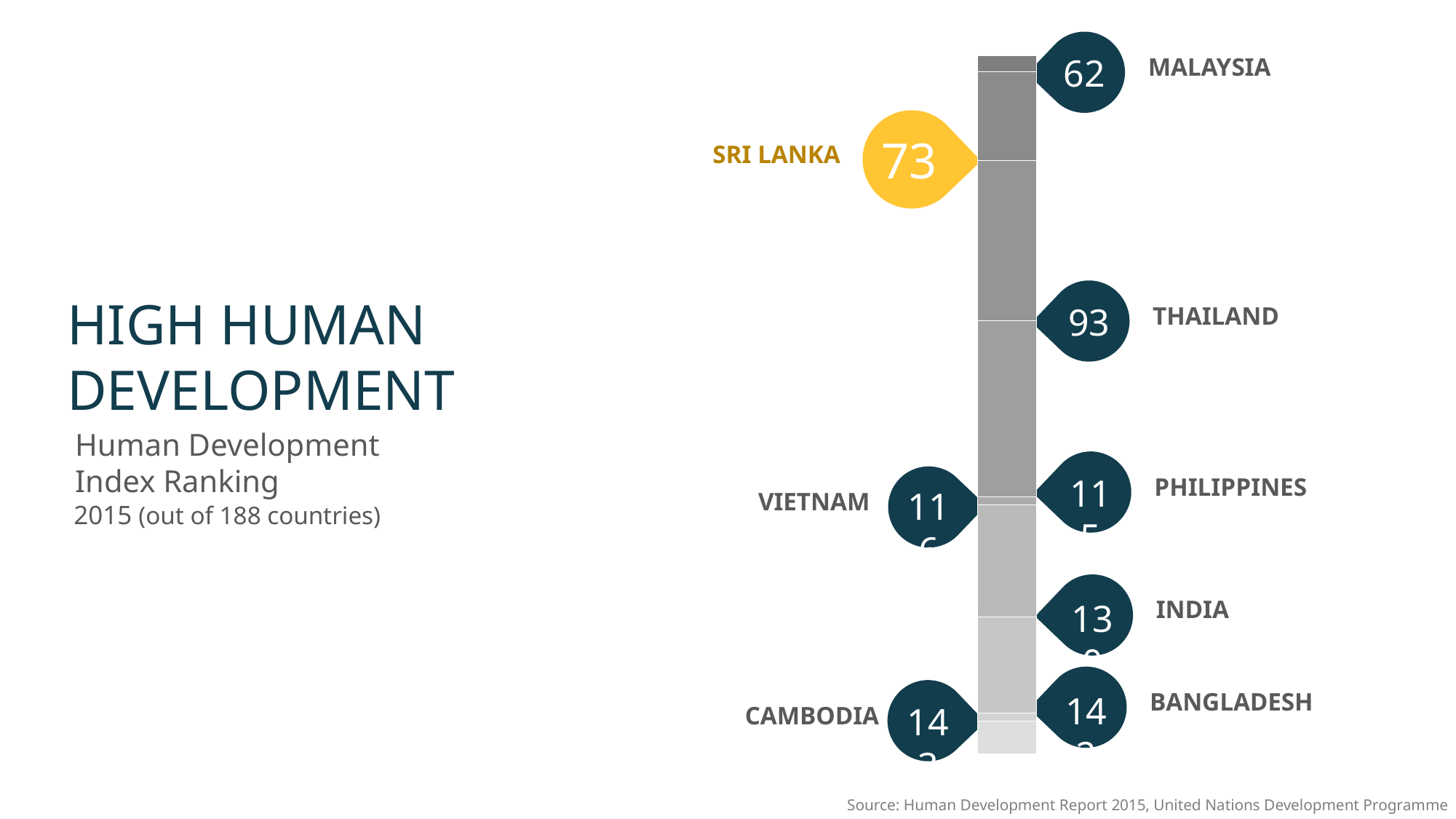
What is the difference between Thailand's ranking and Sri Lanka's ranking? 20 What is the Human Development Index ranking shown for Malaysia? 62 Which country is highlighted in yellow on the chart? Sri Lanka What is the Human Development Index ranking shown for Sri Lanka? 73 Out of how many countries is the 2015 ranking given? 188 What is the difference between Thailand's ranking and Malaysia's ranking? 31 How many countries are marked on the chart? 8 Which has the larger ranking number, Malaysia or Thailand? Thailand Which has the larger ranking number, Sri Lanka or Malaysia? Sri Lanka What is the Human Development Index ranking shown for Thailand? 93 Which country has the lowest (best) ranking number on the chart? Malaysia What is the difference between Sri Lanka's ranking and Malaysia's ranking? 11